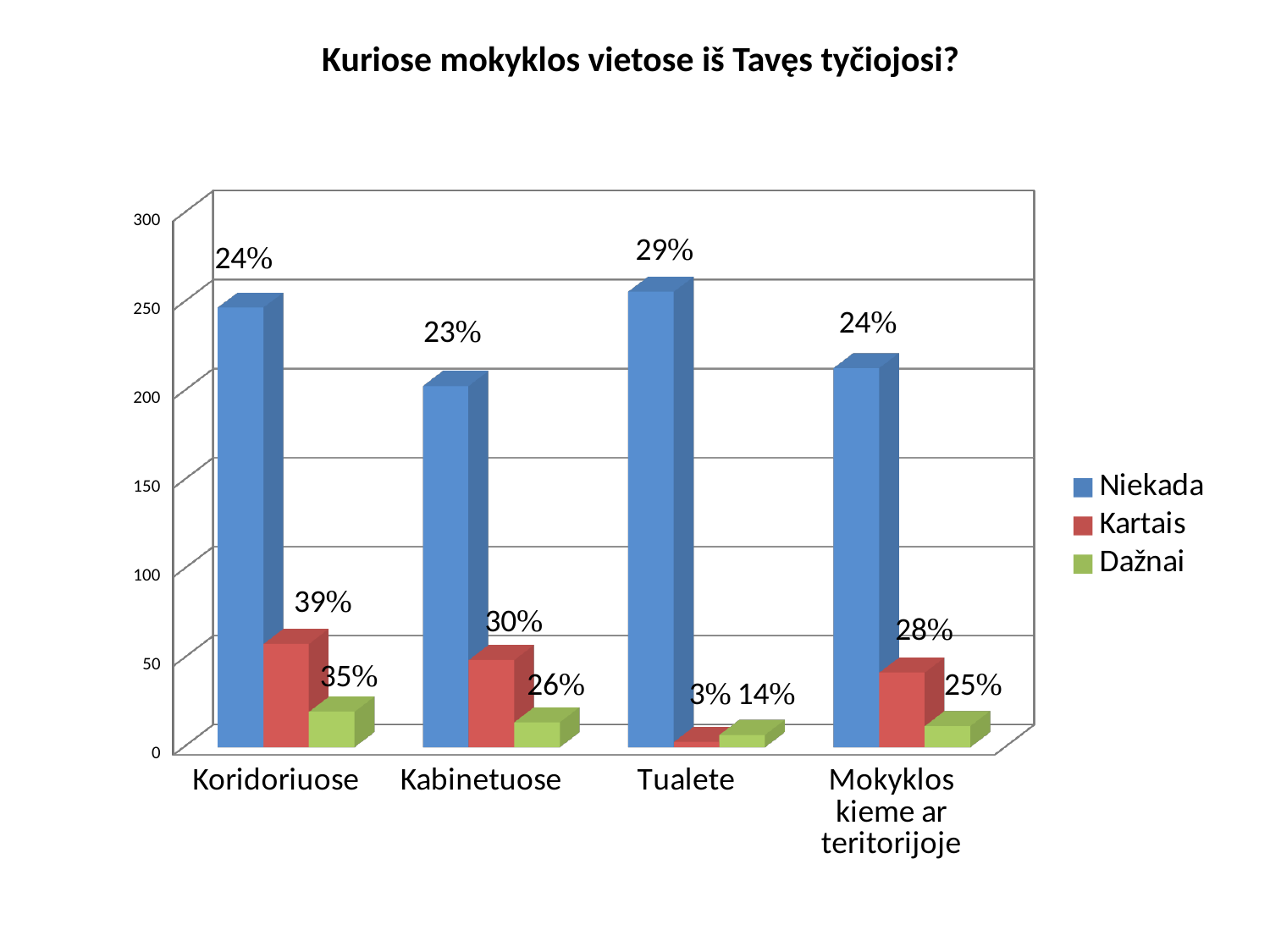
What is the data label for Niekada in Tualete? 29% How many categories are shown on the x axis? 4 Which category has the lowest Dažnai label? Tualete What is the data label for Kartais in Koridoriuose? 39% How many series does the legend list? 3 What is the data label for Dažnai in Kabinetuose? 26% What is the difference in percentage points between the Kartais labels for Koridoriuose and Kabinetuose? 9 Which is larger, the Dažnai label for Koridoriuose or for Mokyklos kieme ar teritorijoje? Koridoriuose What is the data label for Kartais in Mokyklos kieme ar teritorijoje? 28% Which category has the highest Kartais label? Koridoriuose What kind of chart is shown on the slide? bar chart